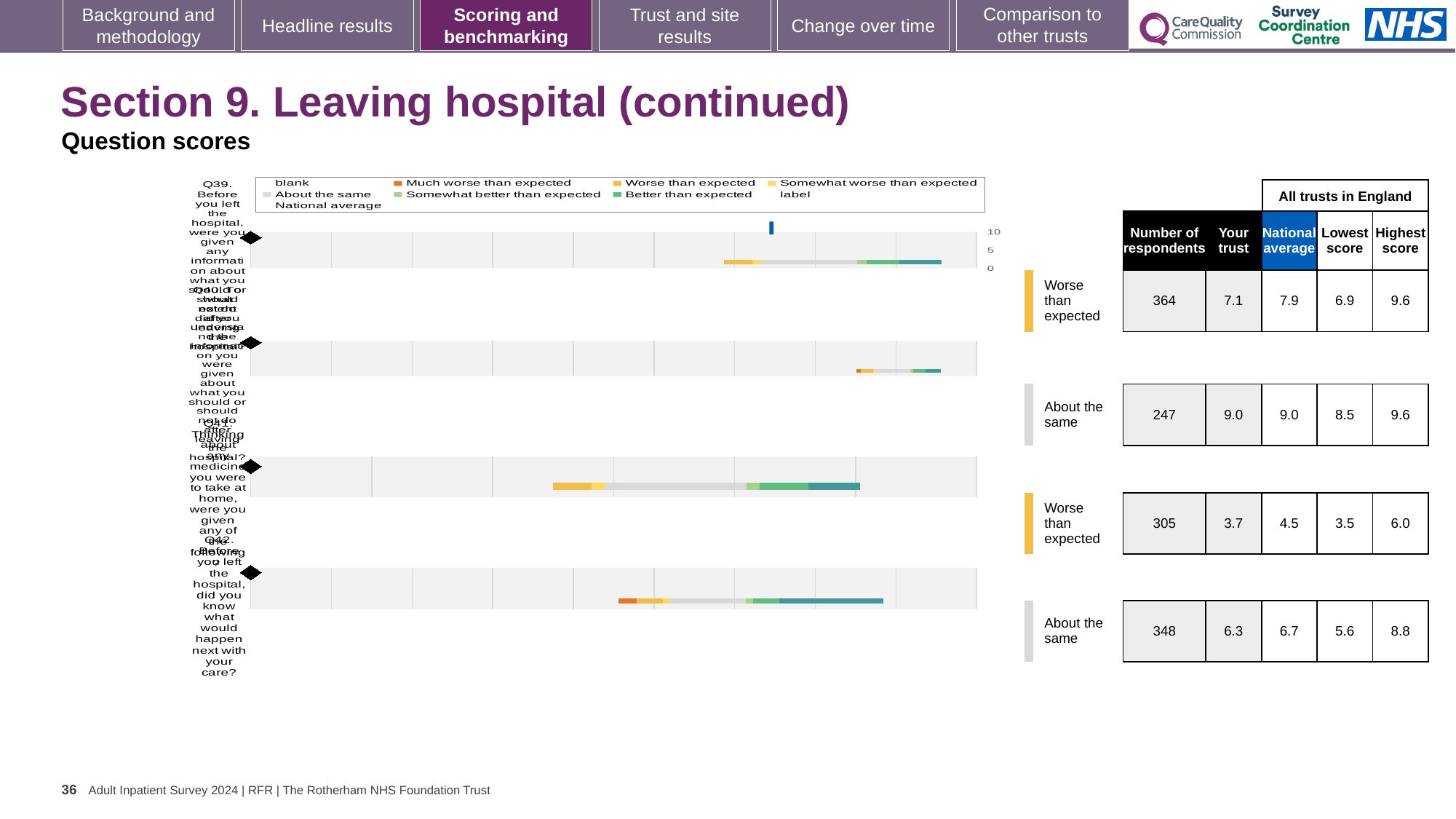
In the table beside the chart, which row has the lowest 'Your trust' score? Q41 (3.7) In the table beside the chart, what is the highest score for the fourth row (Q42)? 8.8 What kind of chart is shown on the slide? bar chart What colour does the legend use for 'Much worse than expected'? orange In the table beside the chart, what is the difference between the national average and 'Your trust' score for the first row (Q39)? 0.8 How many question rows (Q39 to Q42) are plotted in the chart? 4 In the table beside the chart, what is the number of respondents for the second row (Q40)? 247 How many entries does the chart legend list? 9 What colour does the legend use for 'Better than expected'? teal In the table beside the chart, what is the national average for the third row (Q41)? 4.5 In the table beside the chart, is the 'Your trust' score for the second row (Q40) larger or smaller than the 'Your trust' score for the fourth row (Q42)? larger In the table beside the chart, what is the 'Your trust' score for the first row (Q39)? 7.1